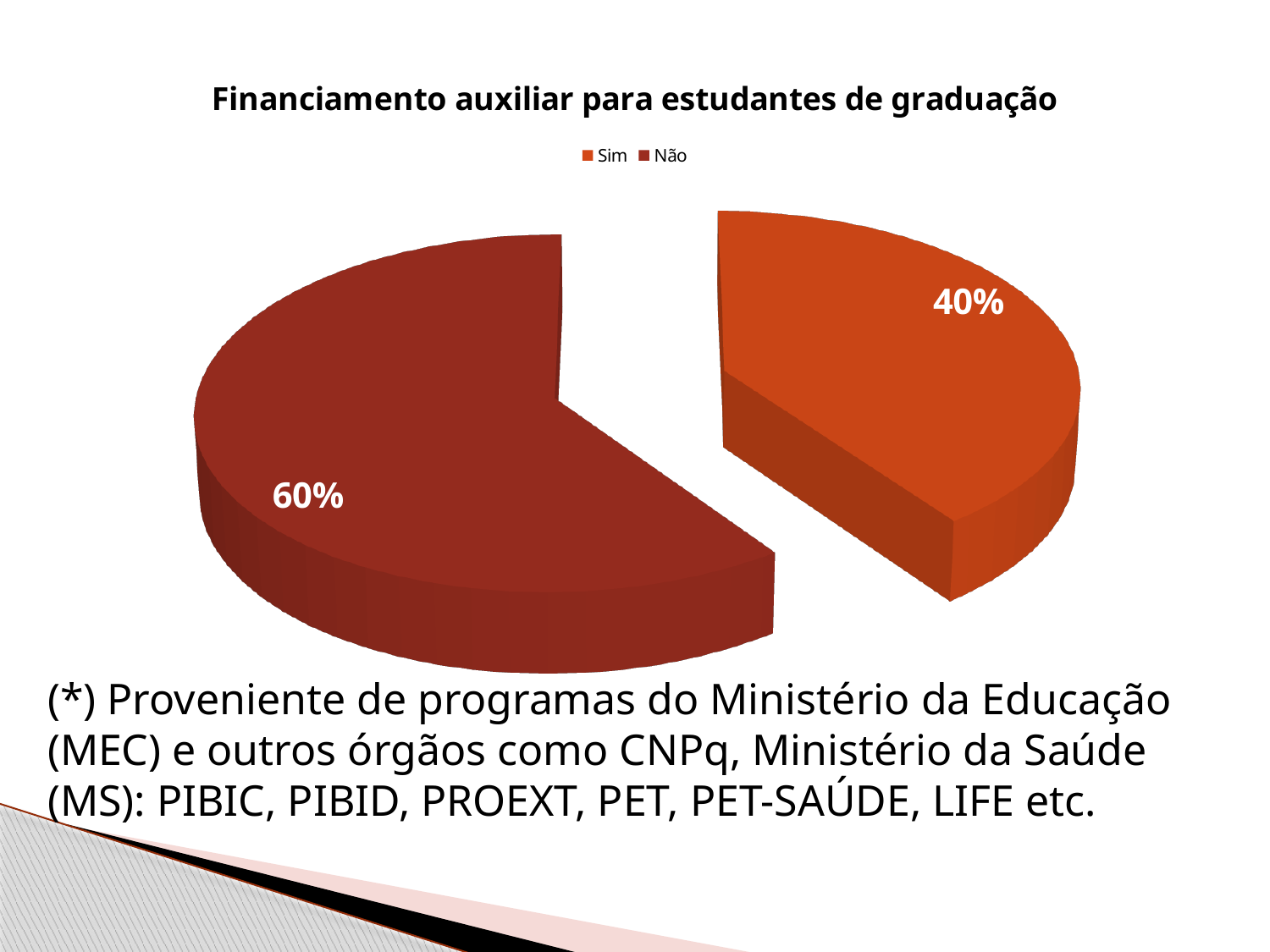
Which legend entry is shown in dark red? Não What kind of chart is shown on the slide? Pie chart How many slices does the pie chart have? 2 Which slice is the largest in the pie chart? Não Which slice is the smallest in the pie chart? Sim What share of the pie does the "Sim" slice represent? 40% What is the difference in percentage points between the "Não" and "Sim" slices? 20% How many entries does the legend list? 2 Which is larger, the "Sim" slice or the "Não" slice? Não What share of the pie does the "Não" slice represent? 60% What is the title of the chart? Financiamento auxiliar para estudantes de graduação